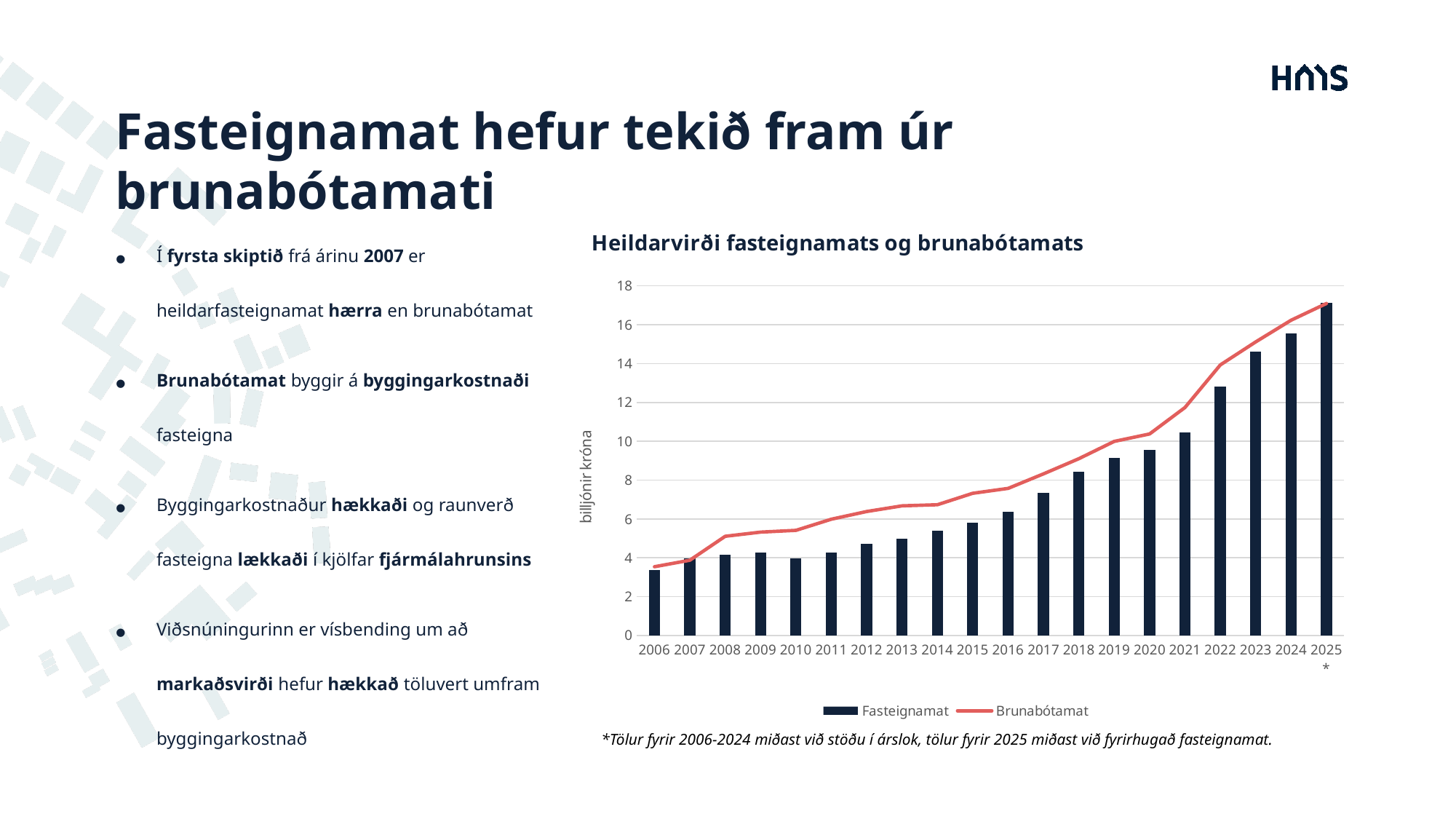
Is the Fasteignamat value for 2022 greater or less than 12? greater Is the Fasteignamat value for 2025 greater or less than 16? greater What is the title of the chart? Heildarvirði fasteignamats og brunabótamats Is the Fasteignamat value for 2006 greater or less than 4? less What kind of chart is shown on the slide? Combined bar and line chart Which year has the lowest Fasteignamat bar? 2006 Do the Fasteignamat values generally rise or fall from 2006 to 2025? rise How many years are shown on the x axis of the chart? 20 In 2022, which is larger: Fasteignamat or Brunabótamat? Brunabótamat Which year has the highest Fasteignamat bar? 2025 How many series does the chart legend list? 2